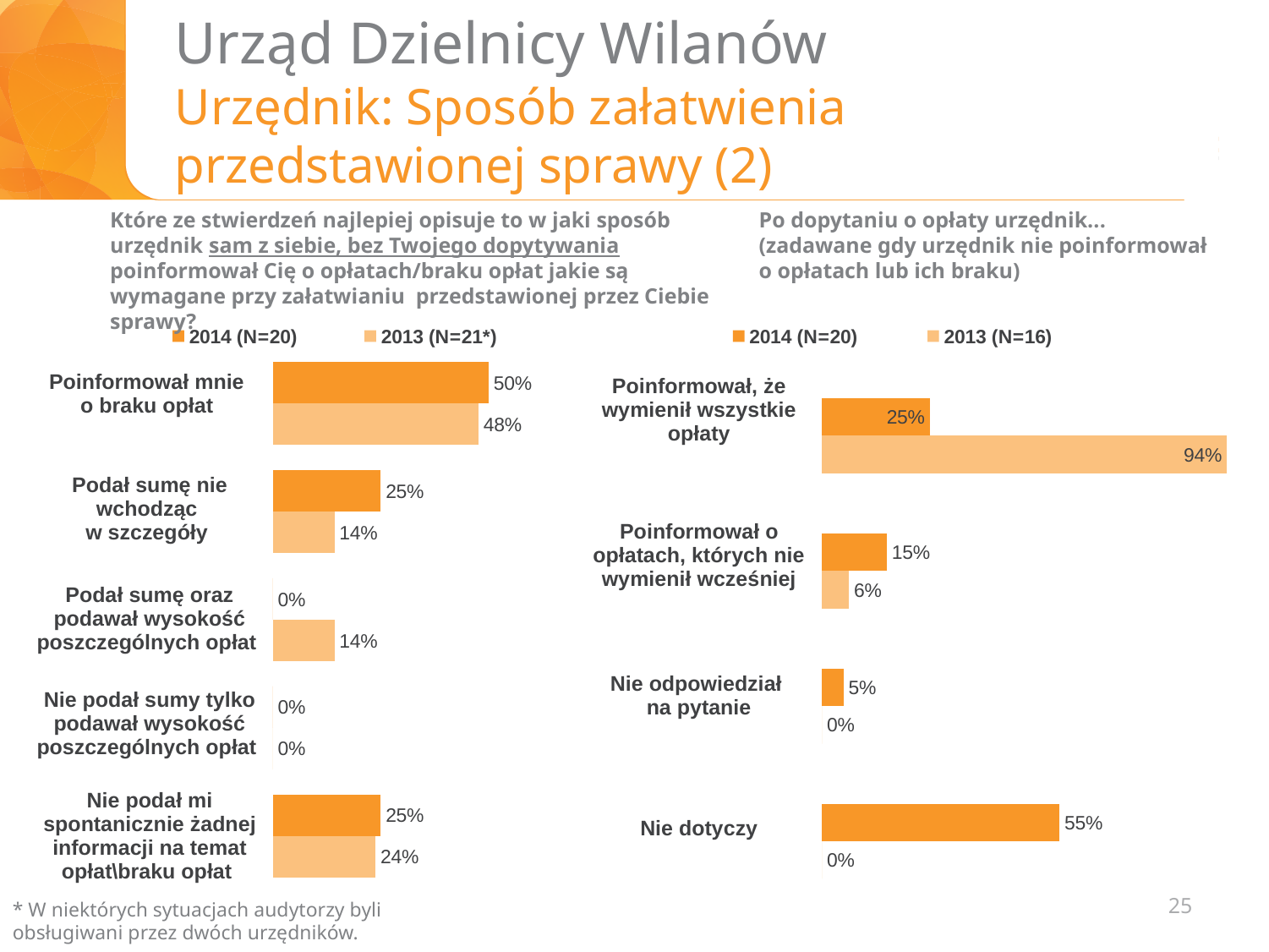
In the right chart, which category has the highest 2014 (N=20) value? Nie dotyczy In the left chart, what is the 2014 (N=20) value for "Poinformował mnie o braku opłat"? 50% In the left chart, how many categories are shown? 5 In the left chart, how many series does the legend list? 2 In the right chart, which is larger for "Poinformował o opłatach, których nie wymieniał wcześniej": the 2014 value or the 2013 value? 2014 (15%) In the right chart, what is the difference between the 2013 and 2014 values for "Poinformował, że wymienił wszystkie opłaty"? 69 percentage points In the left chart, what is the difference between the 2014 and 2013 values for "Podał sumę nie wchodząc w szczegóły"? 11 percentage points In the left chart, which category has the highest 2014 (N=20) value? Poinformował mnie o braku opłat In the right chart, what is the 2013 (N=16) value for "Poinformował, że wymienił wszystkie opłaty"? 94% In the left chart, what is the 2013 (N=21*) value for "Podał sumę nie wchodząc w szczegóły"? 14% What type of chart is used on the right side of the slide? Bar chart In the right chart, what is the 2014 (N=20) value for "Nie dotyczy"? 55%